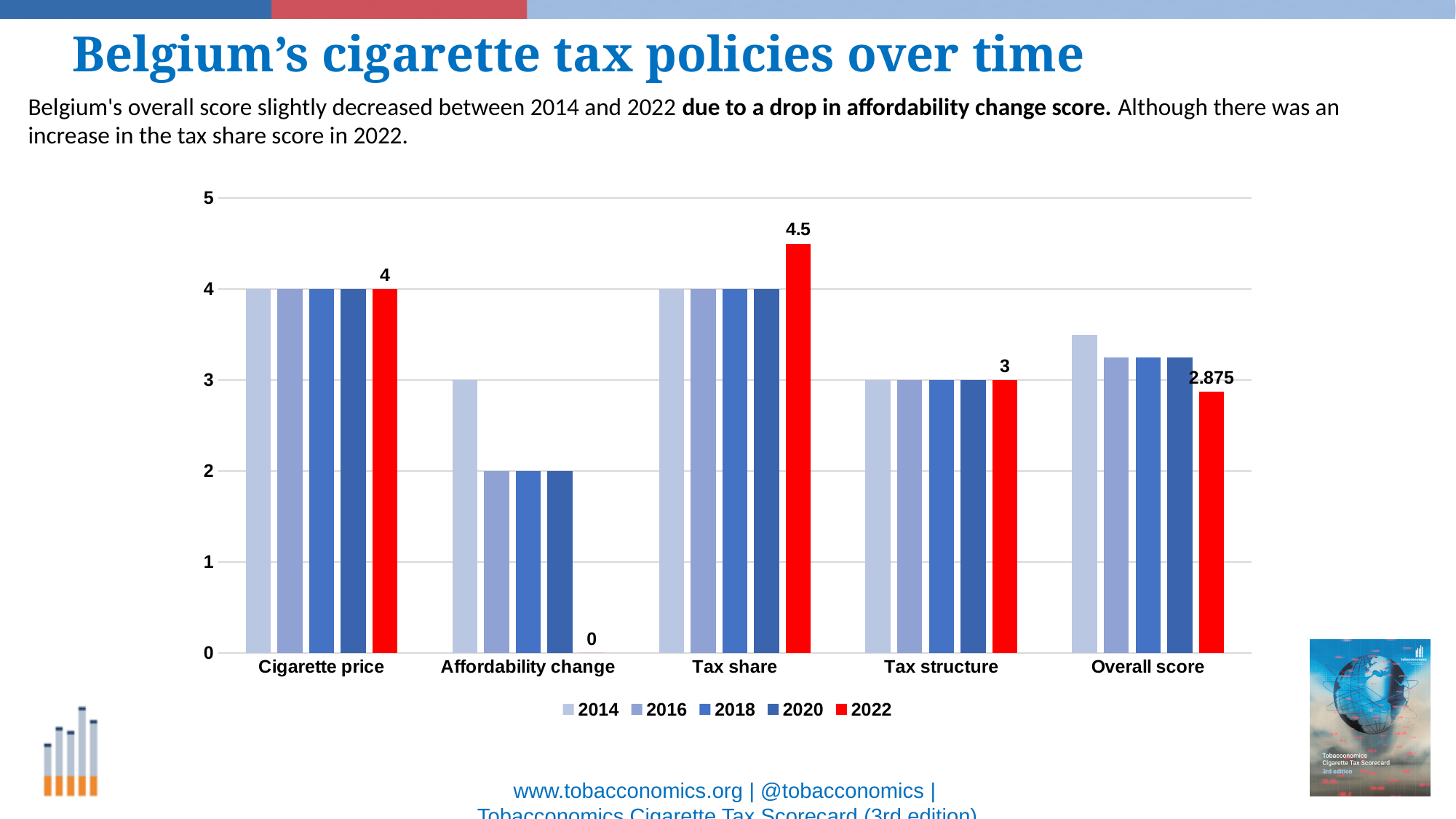
What is the difference between the 2022 values for Tax share and Tax structure? 1.5 Is the 2014 value for Overall score greater or less than 3? greater What is the 2022 value for Overall score? 2.875 Which is larger in 2022: Cigarette price or Overall score? Cigarette price What is the 2014 value for Affordability change? 3 Which category has the lowest 2022 value? Affordability change Which category has the highest 2022 value? Tax share What is the 2022 value for Tax share? 4.5 What kind of chart is shown on the slide? bar chart How many categories are shown on the x axis? 5 What is the 2022 value for Affordability change? 0 How many series does the legend list? 5